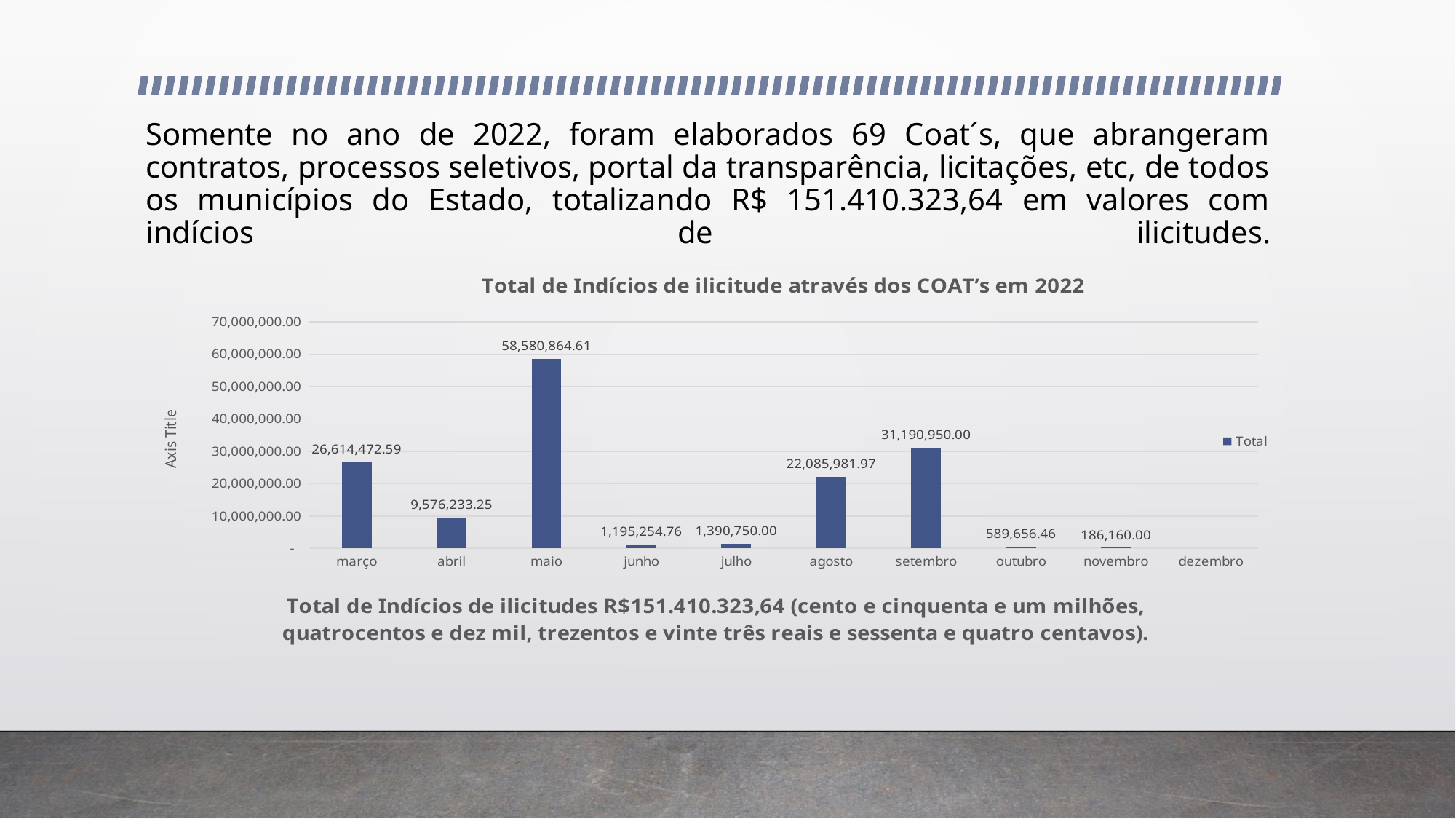
How many series does the legend list? 1 Is the value for setembro greater or less than 30,000,000.00? greater How many months are shown on the x axis? 10 What is the difference between the values for maio and março? 31,966,392.02 What kind of chart is shown? bar chart What is the value for abril? 9,576,233.25 What is the value for setembro? 31,190,950.00 Which month has the highest value? maio What is the value for maio? 58,580,864.61 What is the value for outubro? 589,656.46 Which is larger, the value for março or the value for agosto? março What is the difference between the values for setembro and agosto? 9,104,968.03